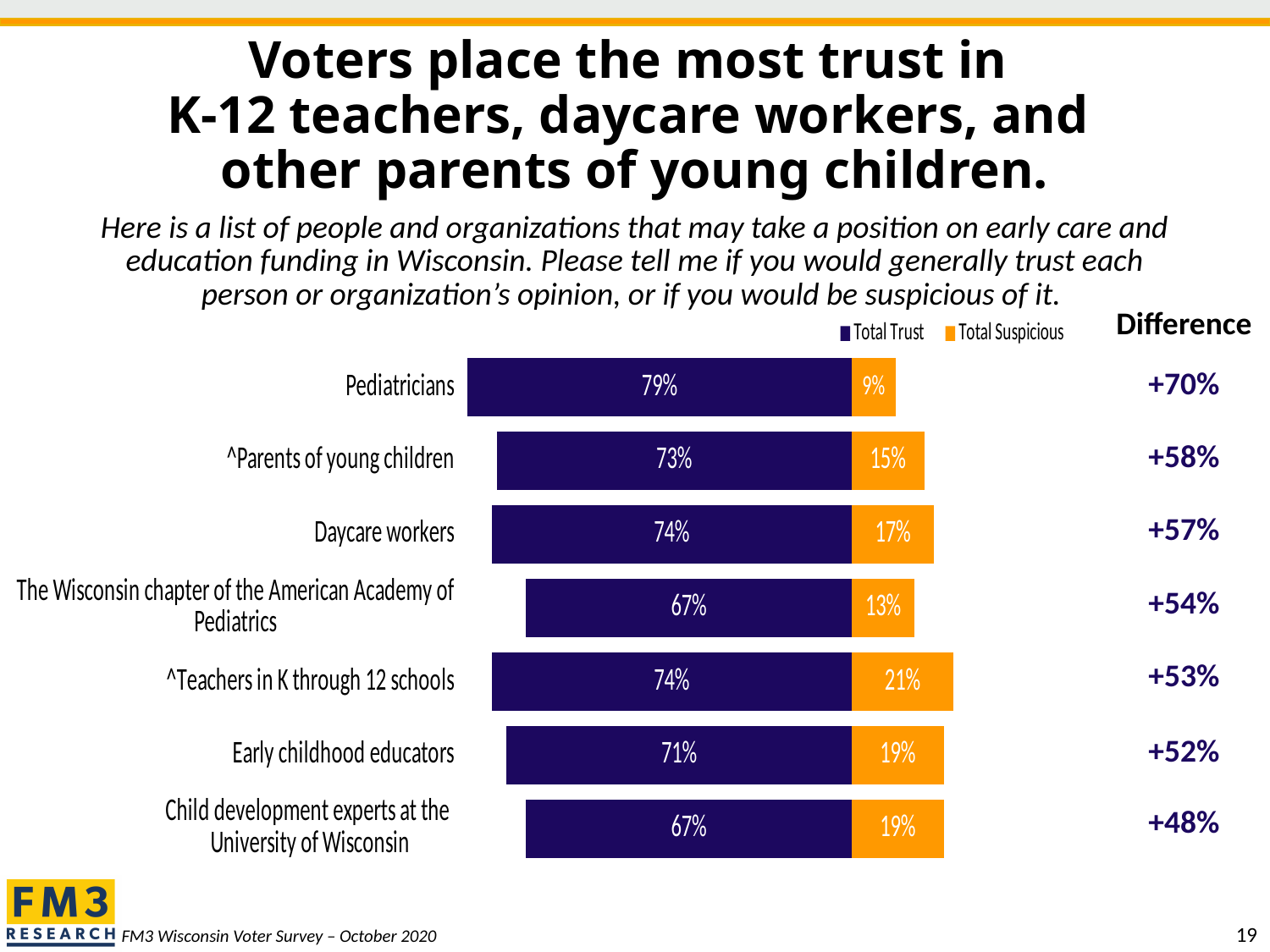
What is the Total Suspicious value for The Wisconsin chapter of the American Academy of Pediatrics? 13% Which is larger: the Total Trust value for ^Parents of young children or for Early childhood educators? ^Parents of young children What percentage of voters say they have Total Trust in Pediatricians? 79% Which category has the highest Total Trust value? Pediatricians Which category has the highest Total Suspicious value? ^Teachers in K through 12 schools What is the Total Trust value for Early childhood educators? 71% What kind of chart is shown on the slide? Bar chart Which category has the lowest Total Suspicious value? Pediatricians What is the difference between the Total Trust and Total Suspicious values for Daycare workers? +57% How many categories are shown in the chart? 7 How many series does the legend list? 2 What is the Total Suspicious value for ^Teachers in K through 12 schools? 21%